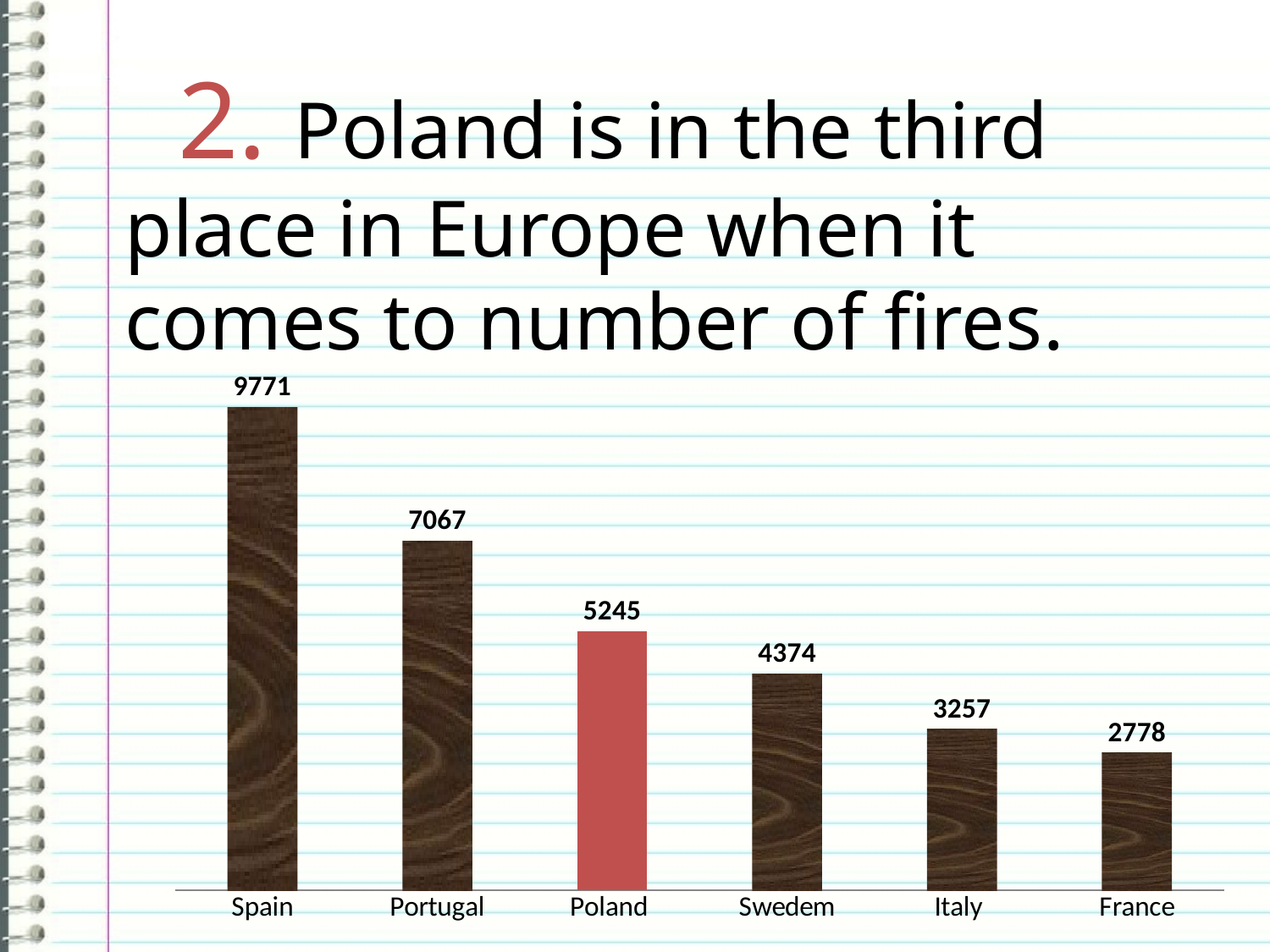
How many countries are shown in the chart? 6 What is the value shown for Italy? 3257 Which country has the highest value in the chart? Spain What kind of chart is shown on the slide? Bar chart What is the value shown for Spain? 9771 What is the value shown for France? 2778 What is the difference between the values for Spain and Portugal? 2704 What is the value shown for Poland? 5245 What is the difference between the values for Poland and Swedem? 871 Which has a larger value, Portugal or Poland? Portugal Which country has the lowest value in the chart? France Which bar in the chart is coloured red rather than brown? Poland